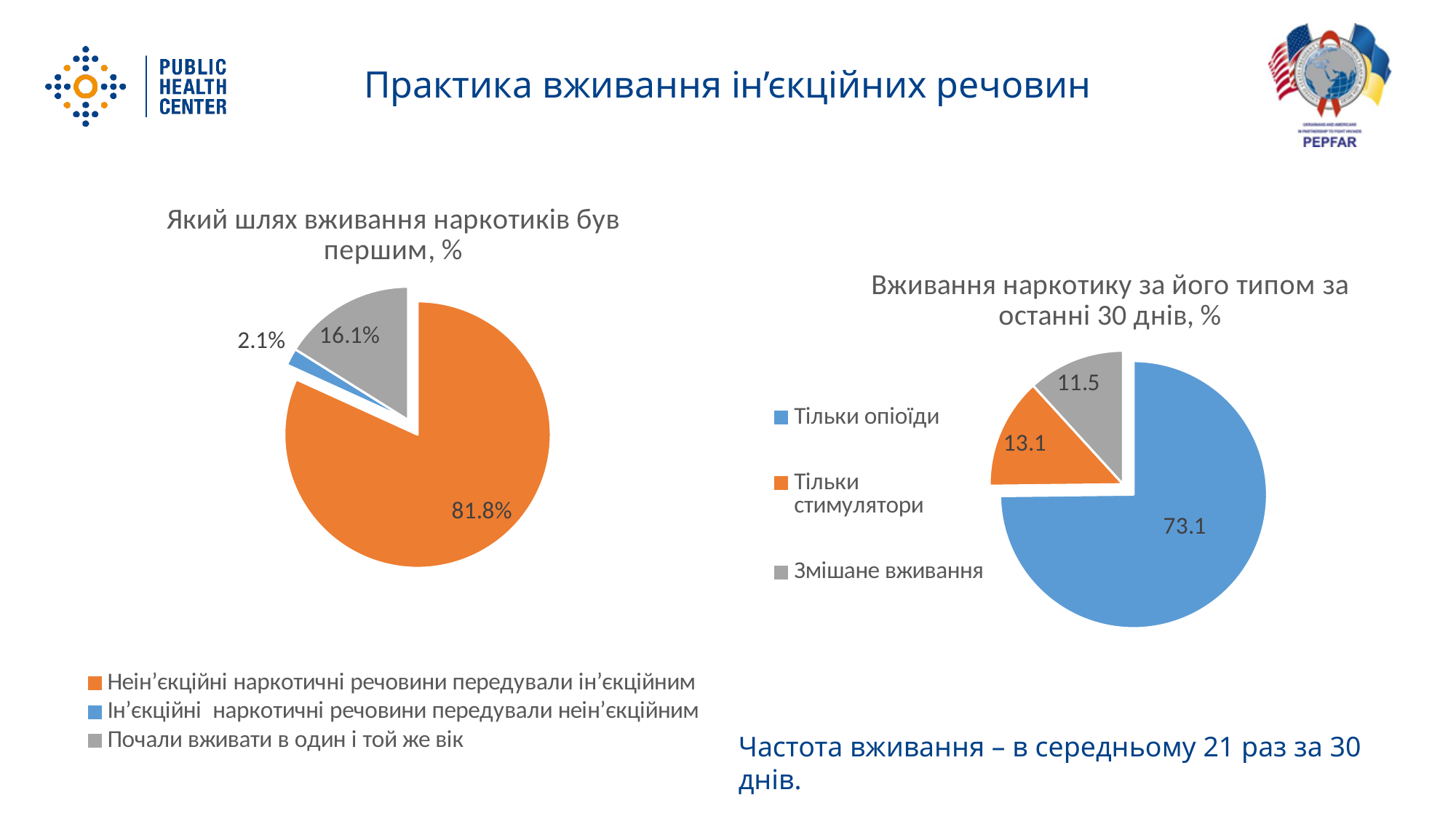
In the right chart 'Вживання наркотику за його типом за останні 30 днів, %', which category has the largest slice? Тільки опіоїди In the left chart 'Який шлях вживання наркотиків був першим, %', what is the difference between the largest slice and the 'Почали вживати в один і той же вік' slice? 65.7% In the right chart 'Вживання наркотику за його типом за останні 30 днів, %', what is the value for 'Змішане вживання'? 11.5 What type of chart is the left chart 'Який шлях вживання наркотиків був першим, %'? Pie chart In the left chart 'Який шлях вживання наркотиків був першим, %', what is the value for 'Почали вживати в один і той же вік'? 16.1% In the left chart 'Який шлях вживання наркотиків був першим, %', which category has the smallest slice? Ін’єкційні наркотичні речовини передували неін’єкційним In the right chart 'Вживання наркотику за його типом за останні 30 днів, %', which is larger: 'Тільки стимулятори' or 'Змішане вживання'? Тільки стимулятори In the left chart 'Який шлях вживання наркотиків був першим, %', how many slices does the pie have? 3 In the left chart 'Який шлях вживання наркотиків був першим, %', what is the value for 'Неін’єкційні наркотичні речовини передували ін’єкційним'? 81.8% In the right chart 'Вживання наркотику за його типом за останні 30 днів, %', what is the difference between 'Тільки опіоїди' and 'Тільки стимулятори'? 60 In the right chart 'Вживання наркотику за його типом за останні 30 днів, %', how many entries does the legend list? 3 In the right chart 'Вживання наркотику за його типом за останні 30 днів, %', what is the value for 'Тільки опіоїди'? 73.1